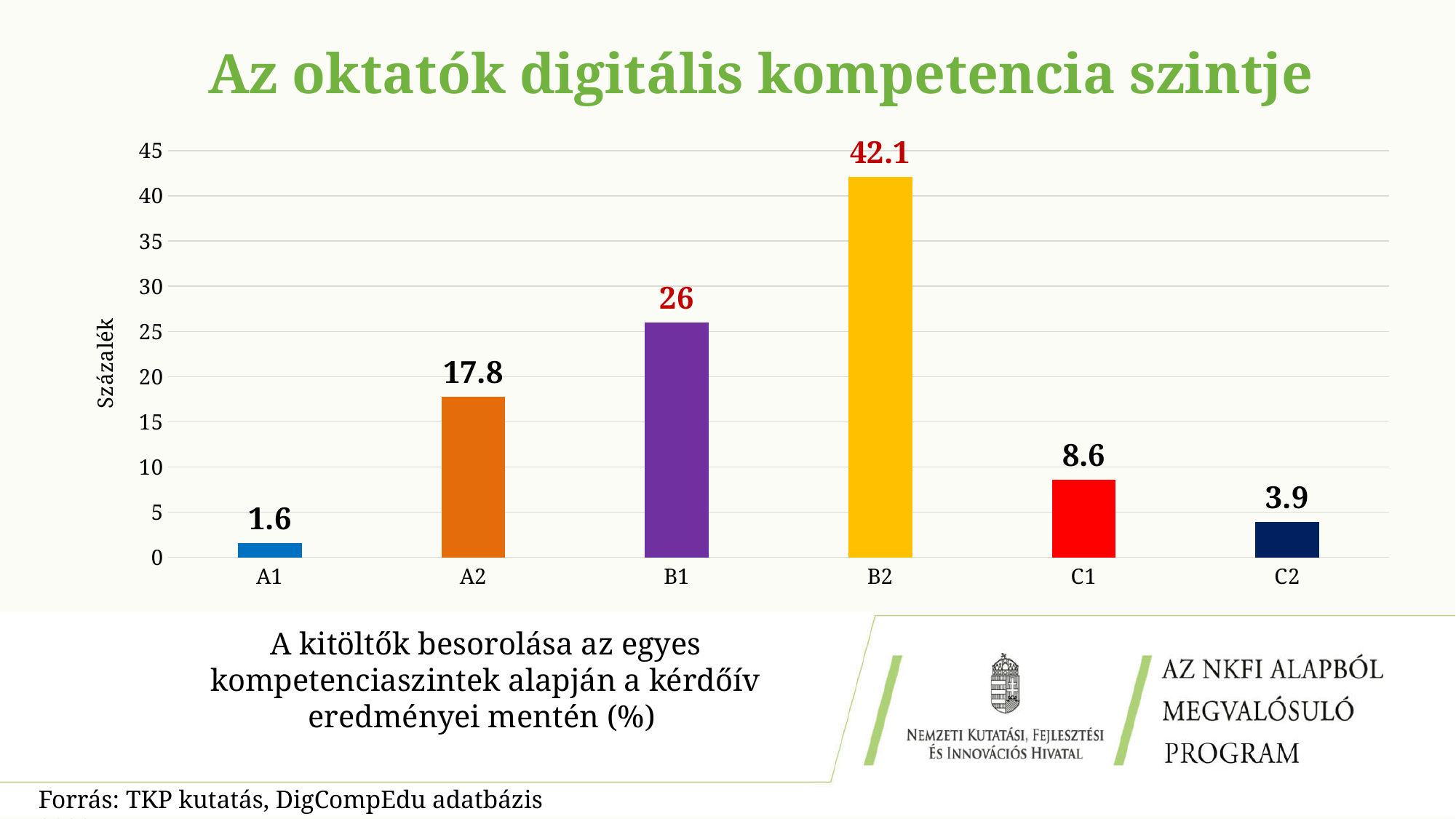
What is the value for B2? 42.1 How many categories are shown on the x axis? 6 Which is larger, the value for A2 or the value for C1? A2 Which category has the highest value? B2 Is the value for B1 greater or less than 25? greater What is the difference between the values for C1 and C2? 4.7 What is the label of the y axis? Százalék What is the value for C2? 3.9 What is the difference between the values for B2 and B1? 16.1 What is the value for A2? 17.8 Which category has the lowest value? A1 What kind of chart is shown on the slide? bar chart